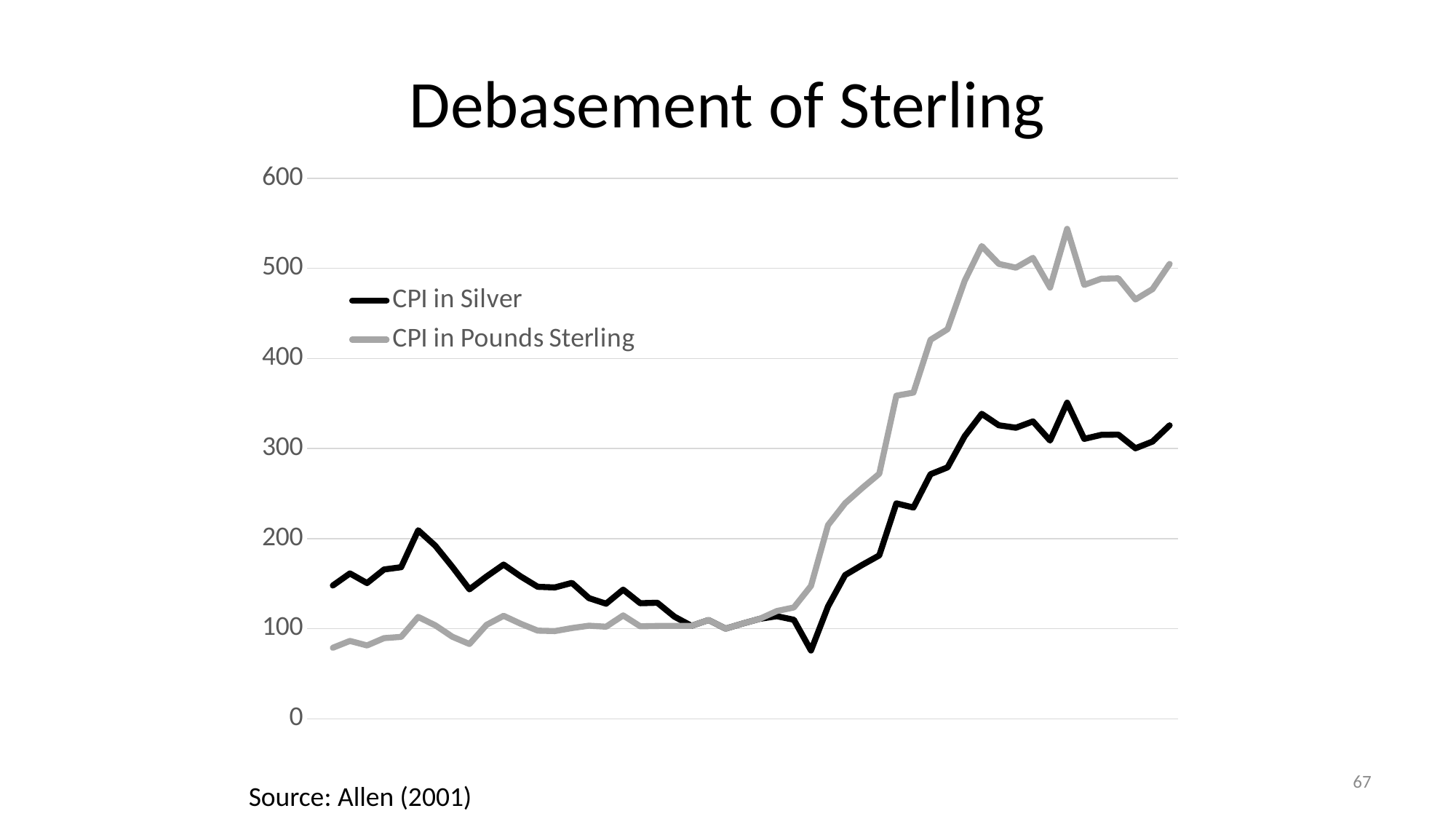
Which series is drawn with the black line? CPI in Silver Is the highest value of the CPI in Pounds Sterling line greater or less than 500? greater What is the title of the chart? Debasement of Sterling How many series does the legend list? 2 Is the lowest value of the CPI in Silver line greater or less than 100? less At the right end of the chart, which series has the higher value, CPI in Silver or CPI in Pounds Sterling? CPI in Pounds Sterling Which series reaches the highest value on the chart? CPI in Pounds Sterling Is the highest value of the CPI in Silver line greater or less than 400? less Overall, does the CPI in Pounds Sterling line rise or fall from left to right? rise At the left end of the chart, which series has the higher value, CPI in Silver or CPI in Pounds Sterling? CPI in Silver What kind of chart is shown on the slide? line chart